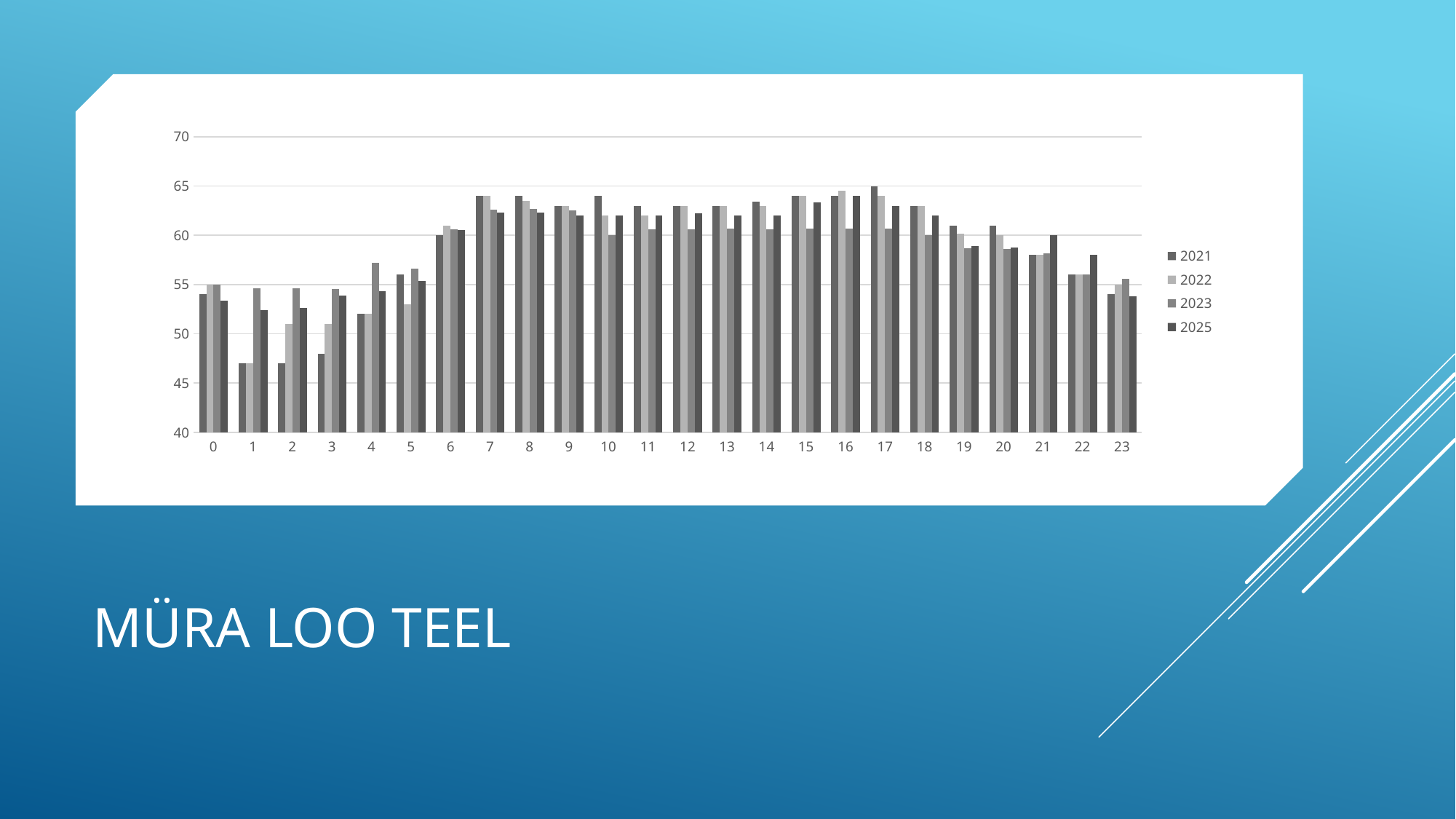
Do the 2021 values rise or fall from hour 1 to hour 7? rise Which is larger for the 2021 series: the value at hour 1 or the value at hour 7? hour 7 Is the value for 2021 at hour 17 greater or less than 60? greater Is the value for 2021 at hour 7 greater or less than 60? greater Is the value for 2023 at hour 4 greater or less than 55? greater How many categories are shown along the x axis of the chart? 24 What kind of chart is shown on the slide? bar chart How many series does the chart's legend list? 4 Which years are listed in the chart's legend? 2021, 2022, 2023, 2025